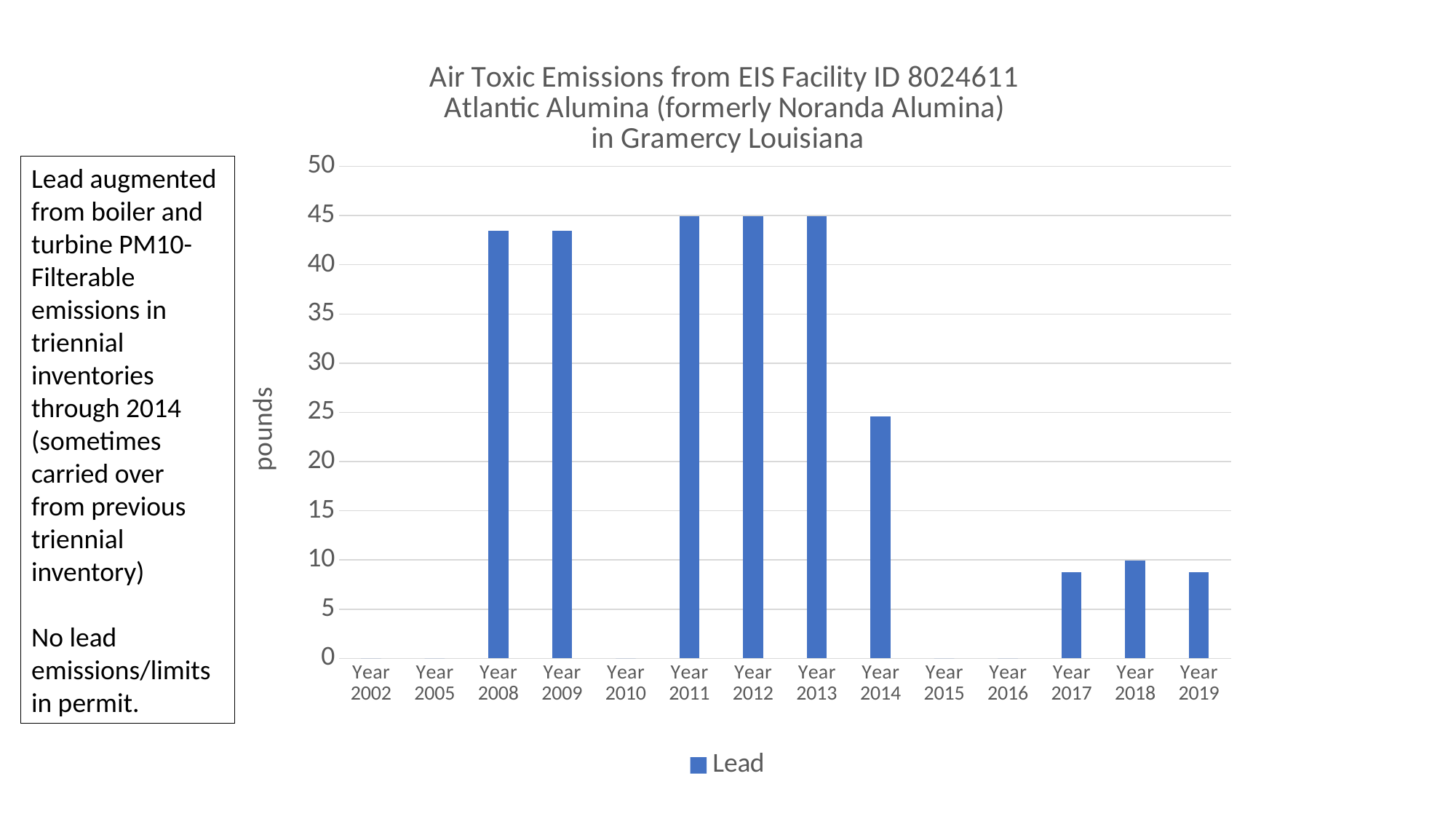
Do the values rise or fall from Year 2013 to Year 2019? fall What kind of chart is shown on the slide? bar chart How many year categories are shown on the x axis? 14 What is the name of the series shown in the legend? Lead Is the value for Year 2014 greater or less than 20? greater What is the label on the vertical axis? pounds How many series does the legend list? 1 Which is larger, the value for Year 2013 or the value for Year 2014? Year 2013 Which is larger, the value for Year 2014 or the value for Year 2018? Year 2014 Is the value for Year 2014 greater or less than 30? less Is the value for Year 2011 greater or less than 40? greater